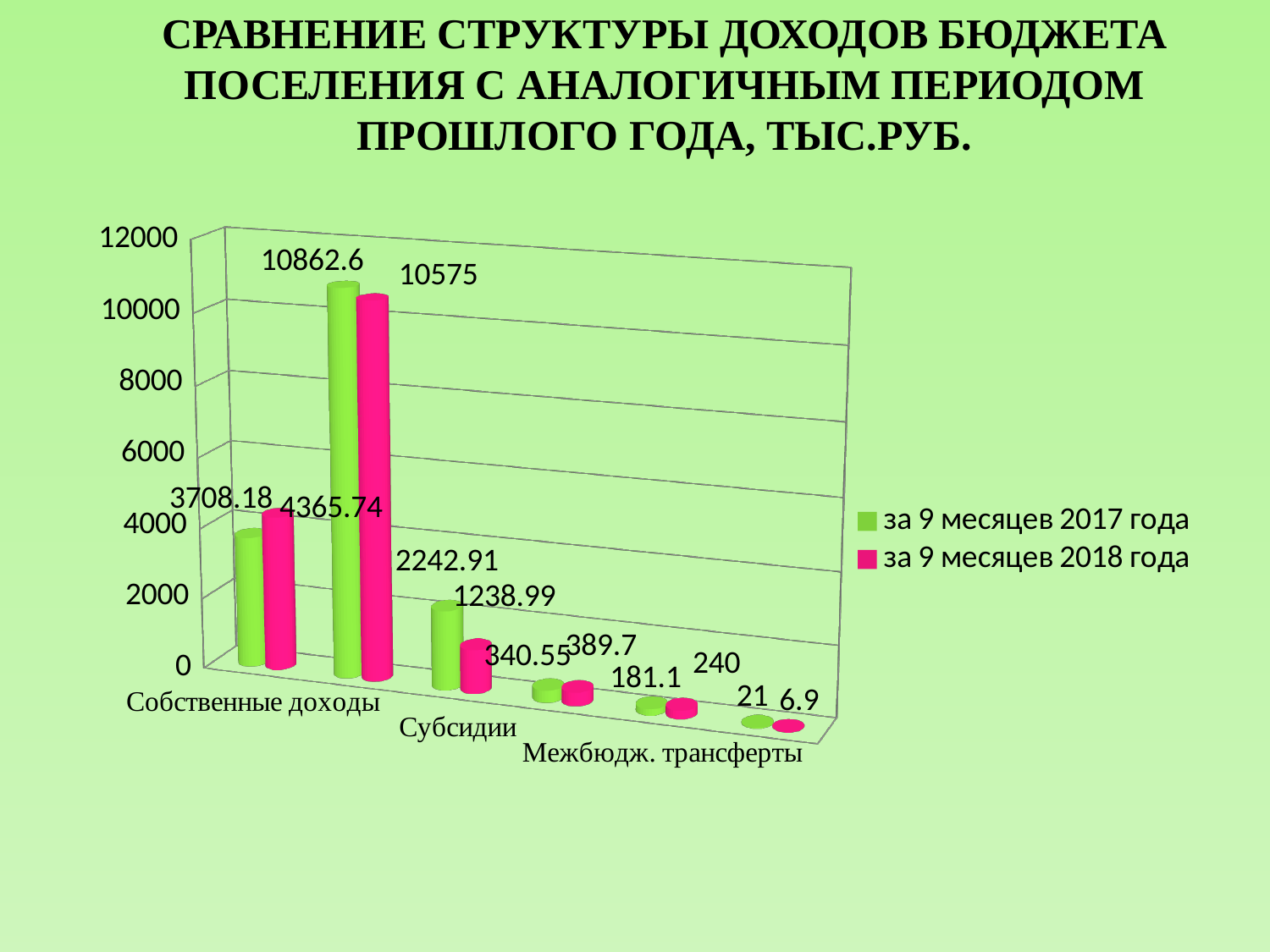
What is the highest value shown on the chart? 10862.6 What is the value for Собственные доходы for за 9 месяцев 2018 года? 4365.74 Which is larger for Межбюдж. трансферты: the value for за 9 месяцев 2017 года or за 9 месяцев 2018 года? за 9 месяцев 2018 года What is the difference between the 2018 and 2017 values for Собственные доходы? 657.56 What is the difference between the 2017 and 2018 values for Субсидии? 1003.92 What is the value for Межбюдж. трансферты for за 9 месяцев 2017 года? 181.1 What is the value for Собственные доходы for за 9 месяцев 2017 года? 3708.18 What kind of chart is shown on the slide? Bar chart How many series does the legend list? 2 How many groups of bars (categories) are shown on the chart? 6 What is the value for Субсидии for за 9 месяцев 2018 года? 1238.99 Which is larger for Субсидии: the value for за 9 месяцев 2017 года or за 9 месяцев 2018 года? за 9 месяцев 2017 года